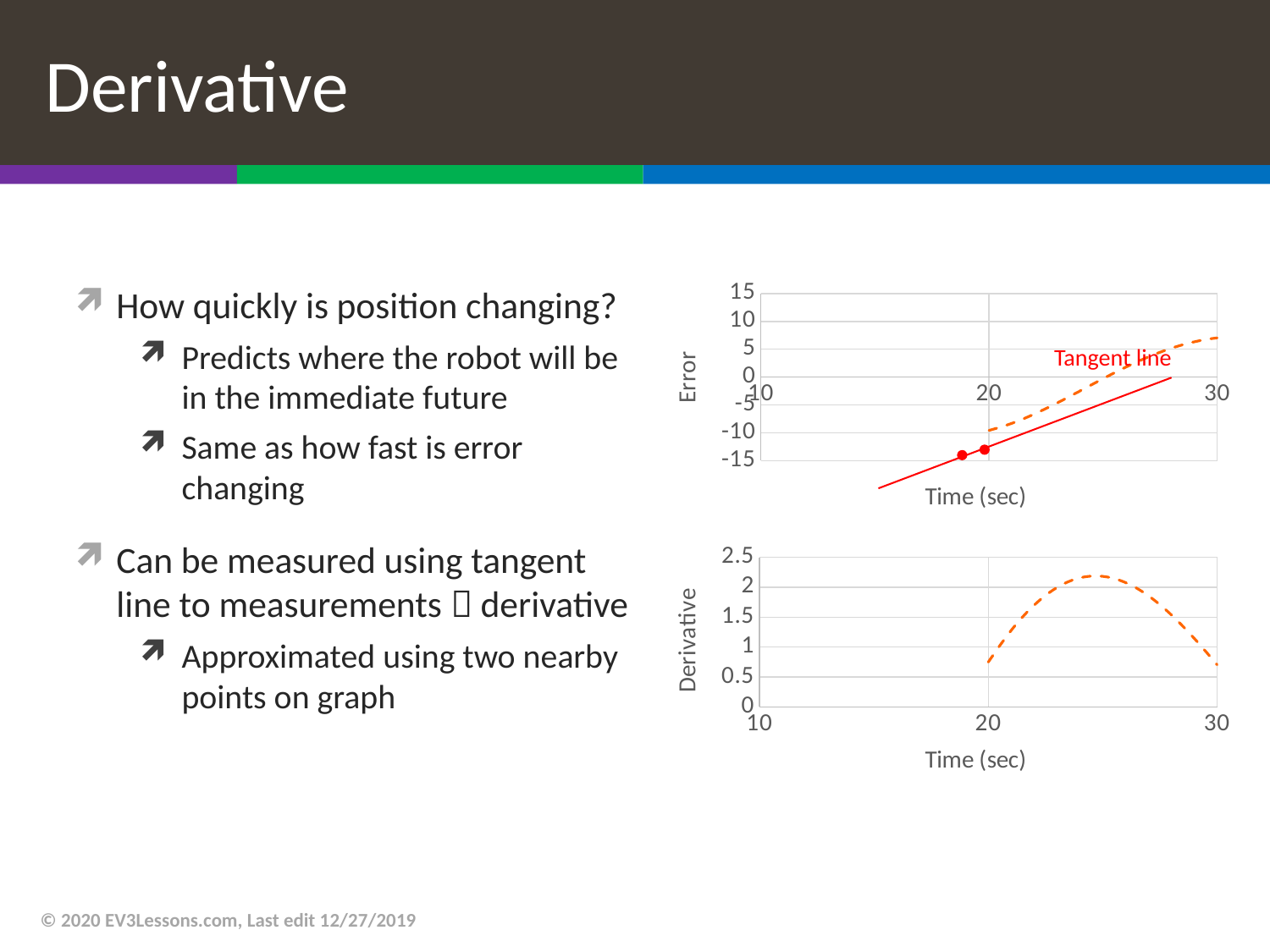
In the top chart, is the Error value at 30 seconds greater or less than 5? greater What kind of chart is the bottom chart (Derivative vs Time)? line chart In the bottom chart, is the Derivative value at 30 seconds greater or less than 1? less How many red points are marked on the top chart? 2 In the bottom chart, does the Derivative rise or fall as time increases from 20 to 25 seconds? rise What kind of chart is the top chart (Error vs Time)? line chart In the top chart, does the dashed Error line rise or fall as time increases from 20 to 30 seconds? rise In the bottom chart, does the Derivative rise or fall as time increases from 25 to 30 seconds? fall In the bottom chart, is the peak Derivative value greater or less than 2? greater What is the x-axis title of the bottom chart? Time (sec) What label is written next to the red straight line in the top chart? Tangent line